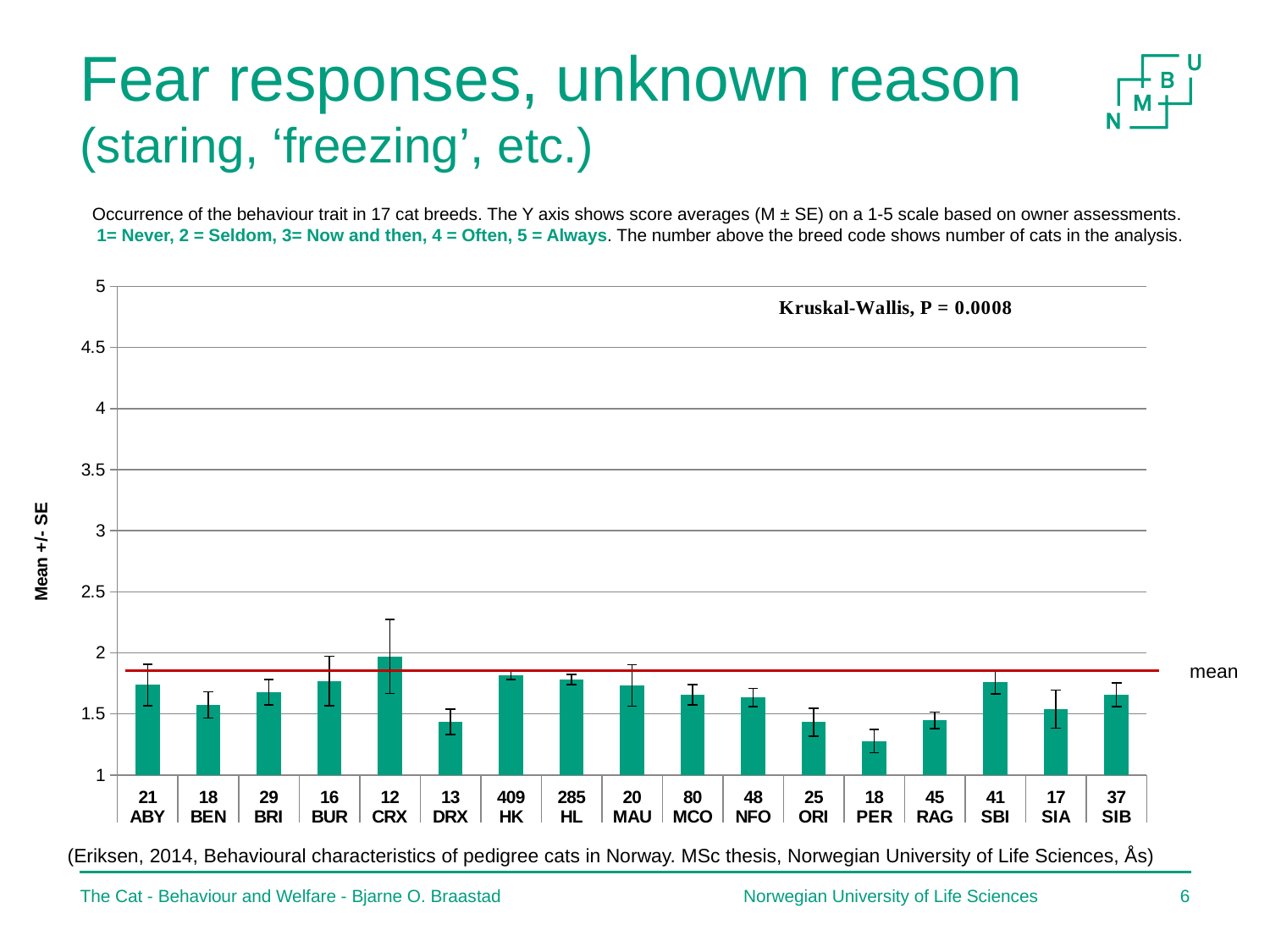
How many cats were included in the analysis for the HK breed, according to the number above the breed code? 409 What Kruskal-Wallis P value is printed on the chart? P = 0.0008 Is the value for DRX greater or less than 1.5? less Which breed has the lowest mean fear response score in the chart? PER Which breed has a higher mean score, HK or DRX? HK Is the value for HK greater or less than 1.5? greater How many cat breeds are plotted on the x axis of the chart? 17 What kind of chart is shown on the slide? bar chart Is the value for PER greater or less than 1.5? less Which breed has a higher mean score, PER or ABY? ABY Which breed has the highest mean fear response score in the chart? CRX